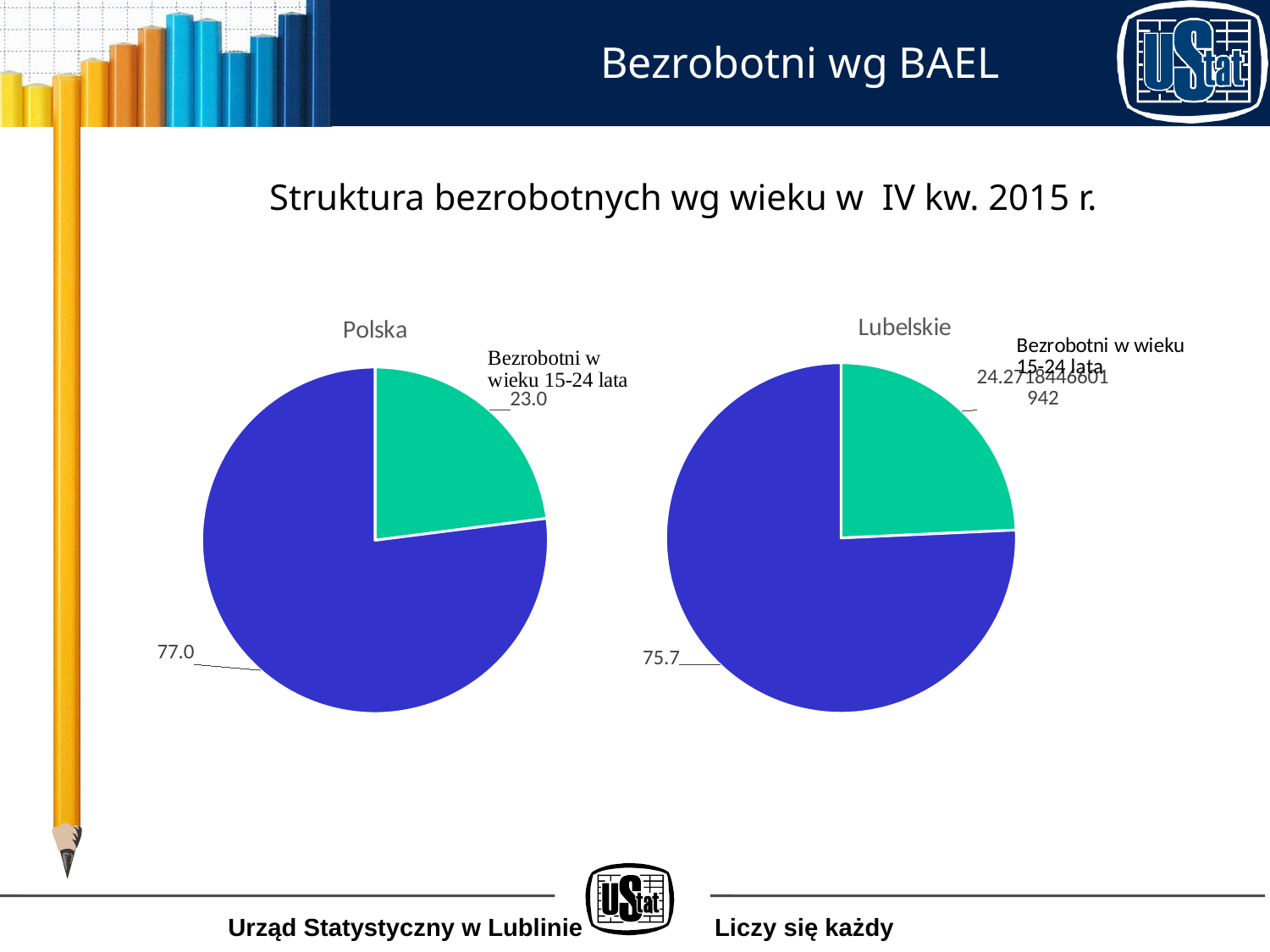
What heading appears above the two pie charts? Struktura bezrobotnych wg wieku w IV kw. 2015 r. What is the title of the pie chart on the right? Lubelskie What is the difference between the blue slice value in the Polska chart (77.0) and the blue slice value in the Lubelskie chart (75.7)? 1.3 In the Polska pie chart, what value is shown for the large blue slice? 77.0 How many slices does the Polska pie chart have? 2 In the Lubelskie pie chart, what value is shown for the large blue slice? 75.7 How many pie charts are shown on the slide? 2 Which is larger: the blue slice in the Polska chart (77.0) or the blue slice in the Lubelskie chart (75.7)? Polska (77.0) In the Polska pie chart, what value is shown for the slice labelled "Bezrobotni w wieku 15-24 lata"? 23.0 What kind of chart is used for Polska and Lubelskie on this slide? pie chart In the Polska pie chart, what is the smallest slice value? 23.0 In the Polska pie chart, which slice is larger: the one for ages 15-24 or the blue slice? the blue slice (77.0)